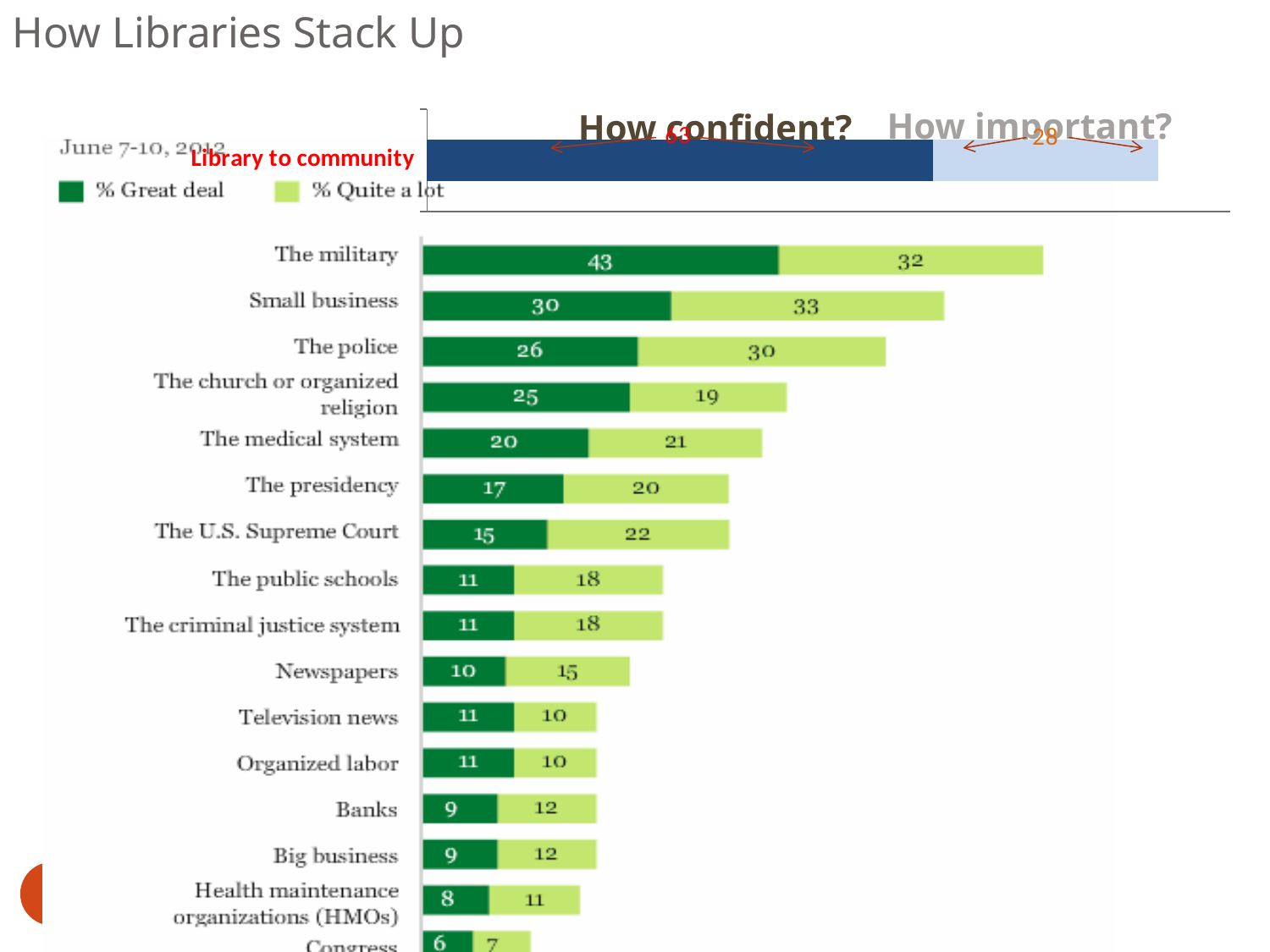
What are the two legend entries of the chart? % Great deal and % Quite a lot What is the % Great deal value for The military? 43 Which category has the highest % Great deal value? The military What is the combined total of % Great deal and % Quite a lot for The medical system? 41 What is the combined total of % Great deal and % Quite a lot for The police? 56 Which has the larger % Quite a lot value, The U.S. Supreme Court or The presidency? The U.S. Supreme Court What kind of chart is shown on the slide? Stacked bar chart How many series does the legend list? 2 What is the % Great deal value for Banks? 9 What is the % Quite a lot value for Small business? 33 What is the % Quite a lot value for Newspapers? 15 What is the difference between the % Great deal values for The military and Small business? 13